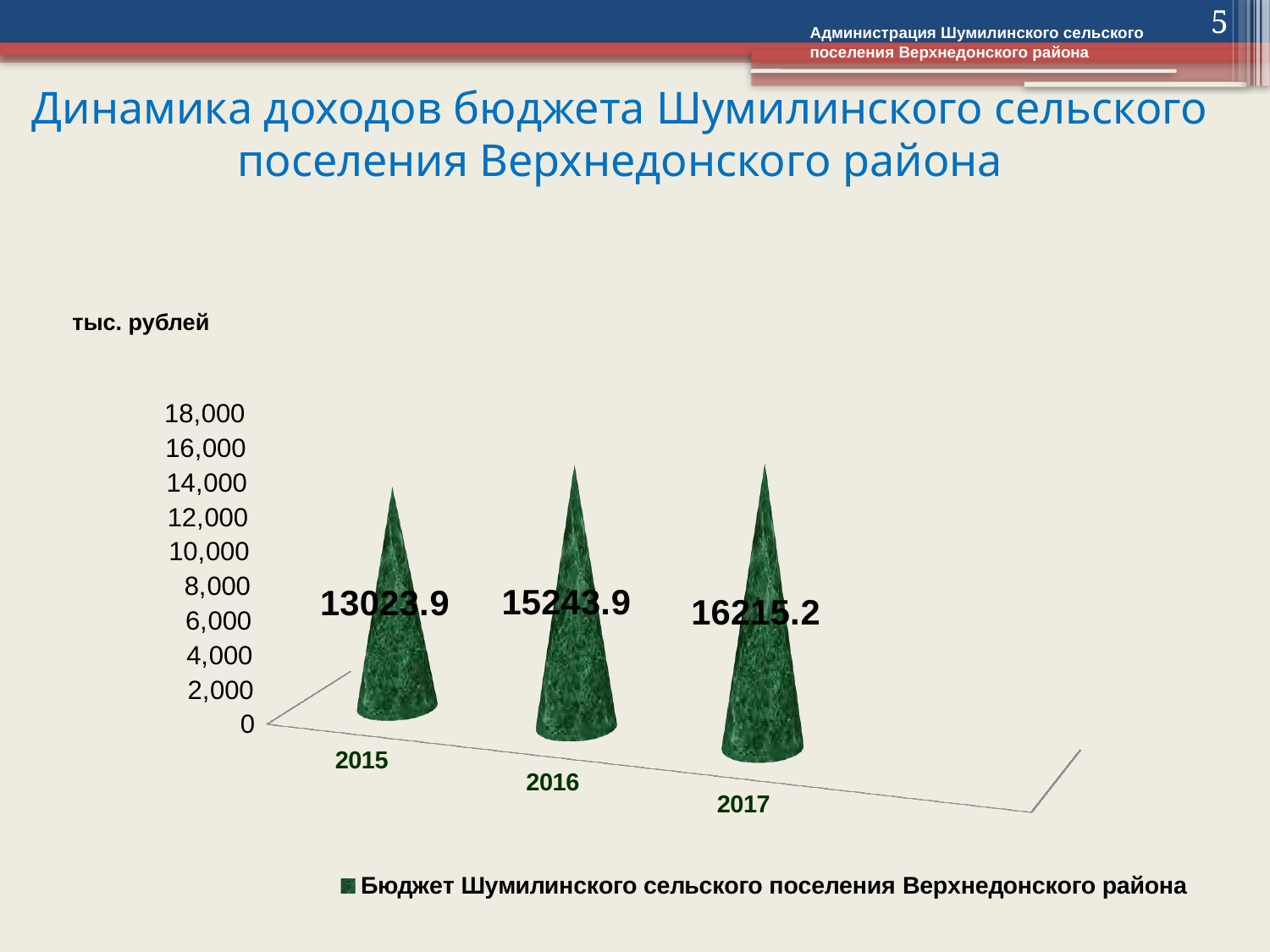
How many years are shown on the chart? 3 What is the budget revenue value for 2015? 13023.9 How many series does the legend list? 1 Which year has the highest budget revenue? 2017 What is the budget revenue value for 2017? 16215.2 What unit is stated above the chart? тыс. рублей What is the difference between the 2017 and 2015 values? 3191.3 What is the difference between the 2016 and 2015 values? 2220.0 Do the values rise or fall from 2015 to 2017? rise Which year has the lowest budget revenue? 2015 What is the budget revenue value for 2016? 15243.9 Which is larger, the value for 2016 or the value for 2017? 2017